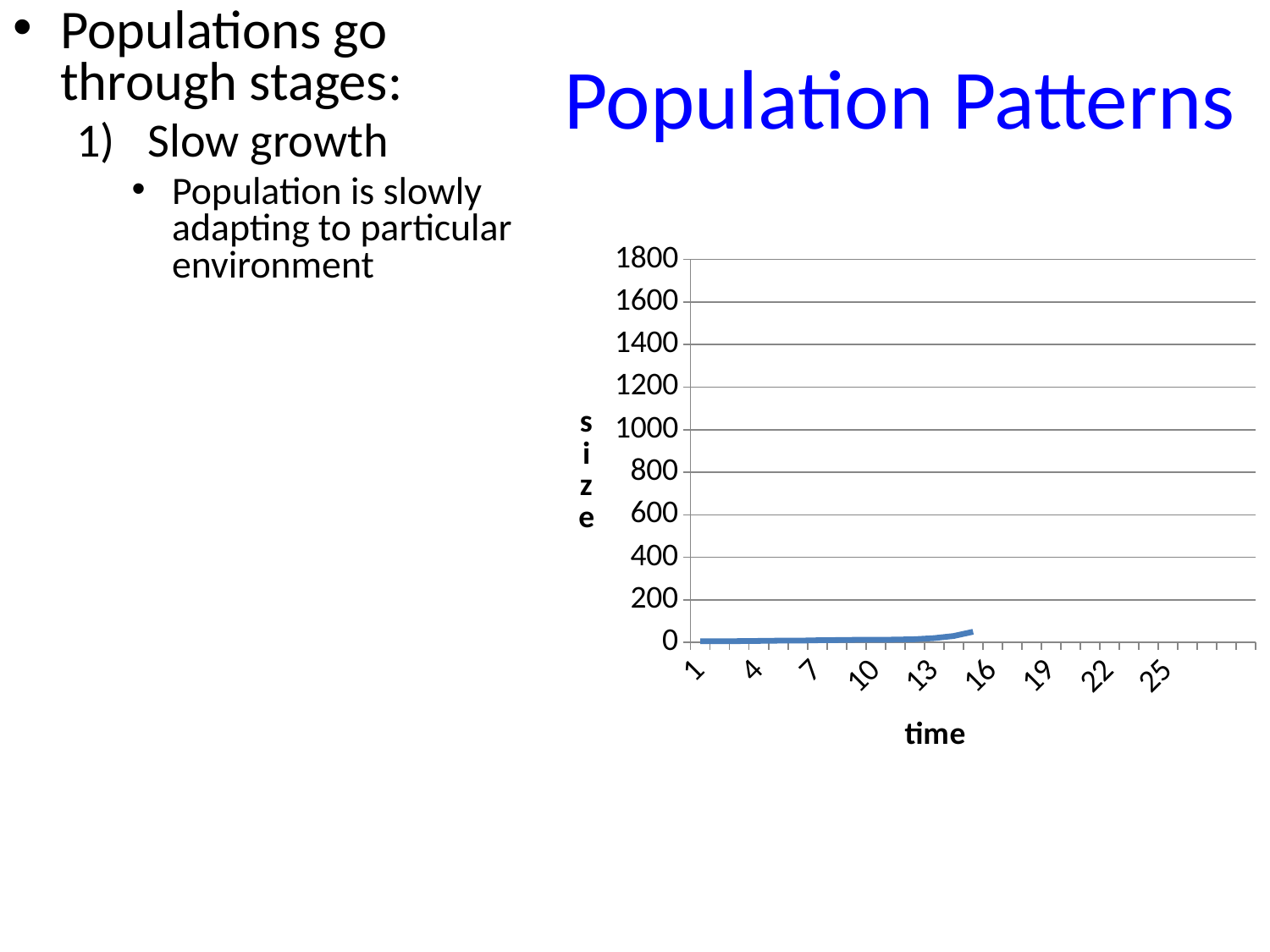
Is the value for time 1 greater or less than 200? less What kind of chart is shown on the slide? line chart What is the highest value shown on the y axis? 1800 What is the label of the x axis? time Is the value for time 10 greater or less than 400? less Is the value for time 13 greater or less than 200? less Do the plotted values rise or fall as time increases along the x axis? rise